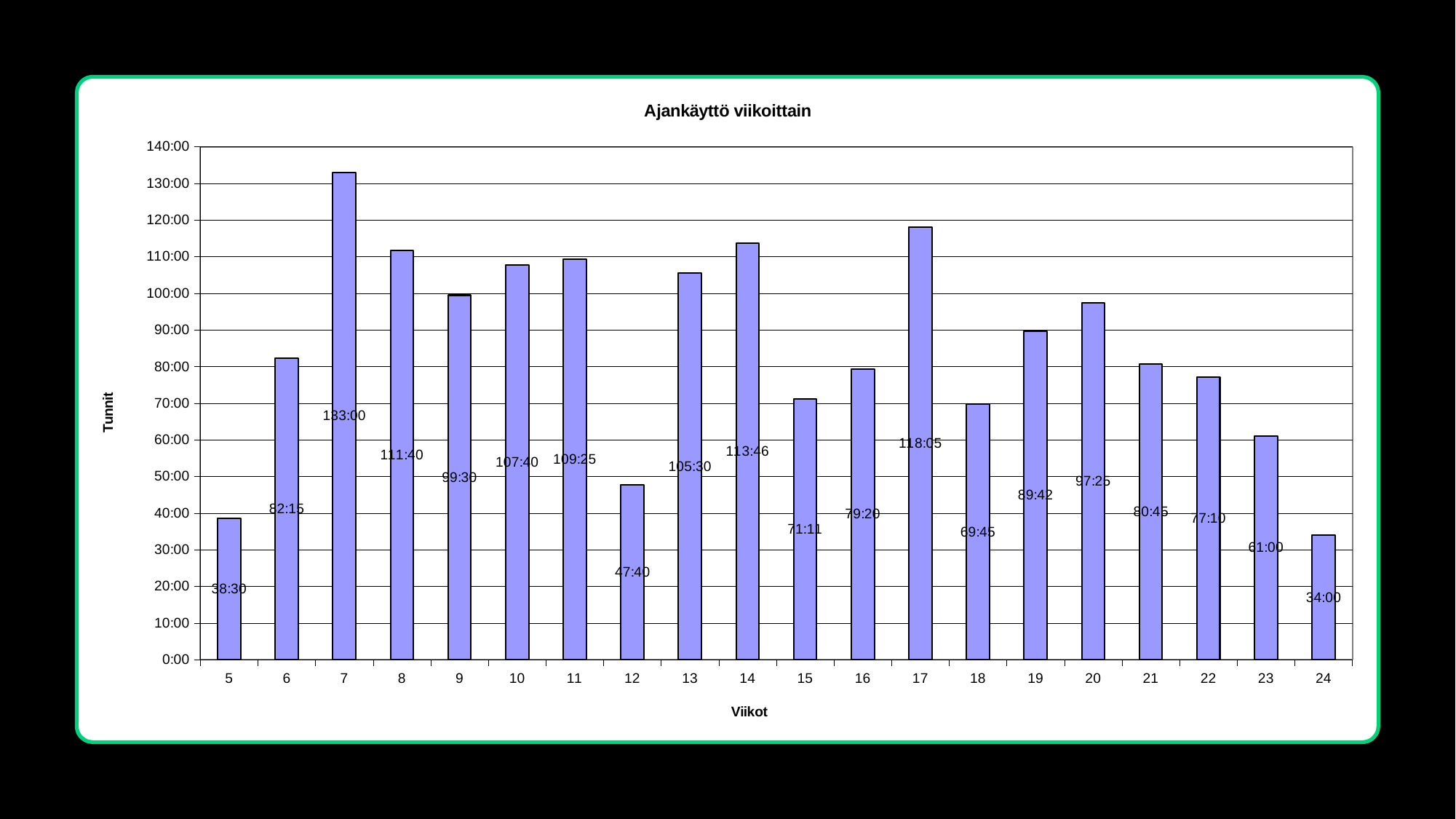
What is the value for week 7? 133:00 Which week has the lowest value? 24 What is the value for week 19? 89:42 Which week has the highest value? 7 Is the value for week 12 greater or less than 50:00? less What is the value for week 15? 71:11 How many weeks are shown on the x axis? 20 What is the difference between the values for week 7 and week 23? 72:00 What is the difference between the values for week 23 and week 24? 27:00 What kind of chart is this? bar chart What is the title of the chart? Ajankäyttö viikoittain Which is larger, the value for week 13 or week 14? week 14